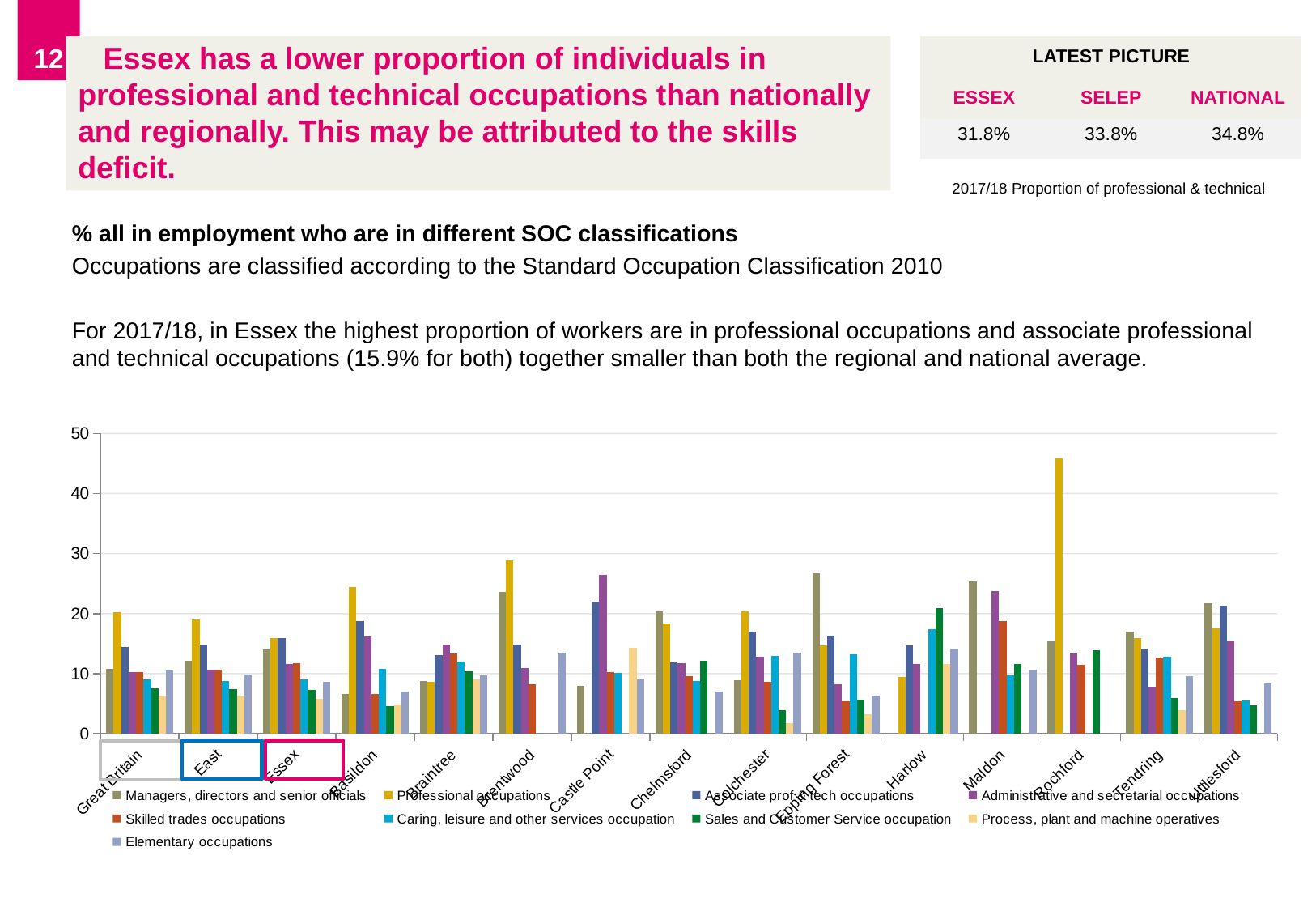
Is the value for Professional occupations in Rochford greater or less than 40? greater Is the value for Administrative and secretarial occupations in Castle Point greater or less than 20? greater Which category has the highest value for Professional occupations? Rochford Which is larger: Administrative and secretarial occupations in Castle Point or in Chelmsford? Castle Point Is the value for Professional occupations in Brentwood greater or less than 20? greater What kind of chart is shown on the slide? bar chart Which is larger: Professional occupations in Rochford or Professional occupations in Brentwood? Rochford What is the first category shown on the x axis of the chart? Great Britain How many series does the chart's legend list? 9 How many categories are shown along the x axis of the chart? 15